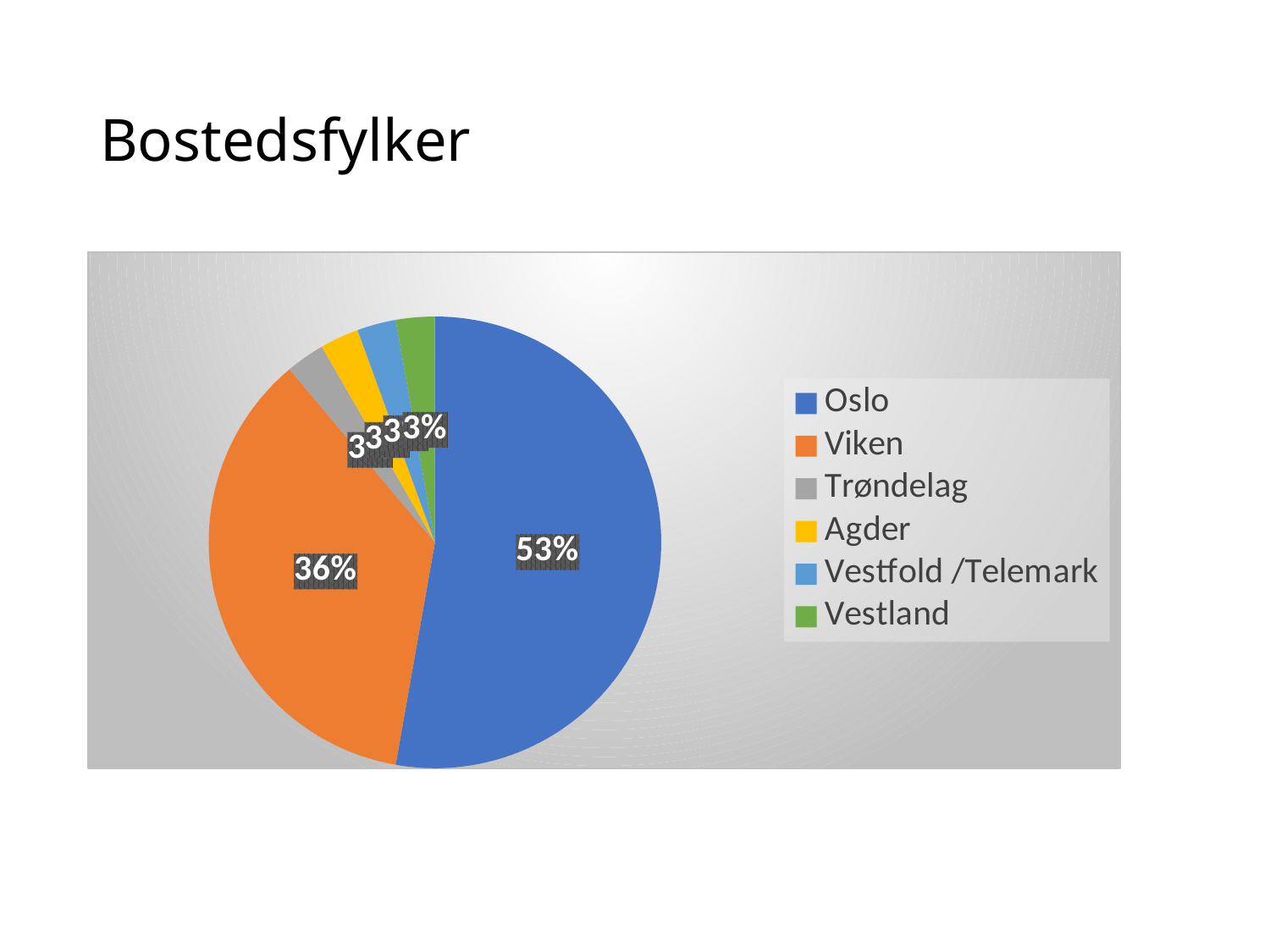
What kind of chart is shown on the slide? Pie chart What colour is the slice for Viken? Orange What share of the pie does Oslo account for? 53% Which category has the second largest slice of the pie? Viken How many categories are shown in the pie chart? 6 Which category has the largest slice of the pie? Oslo What share of the pie does Viken account for? 36% By how many percentage points does Oslo's share exceed Viken's share? 17 percentage points What is the title of the slide containing the pie chart? Bostedsfylker Which is larger, the slice for Oslo or the slice for Viken? Oslo